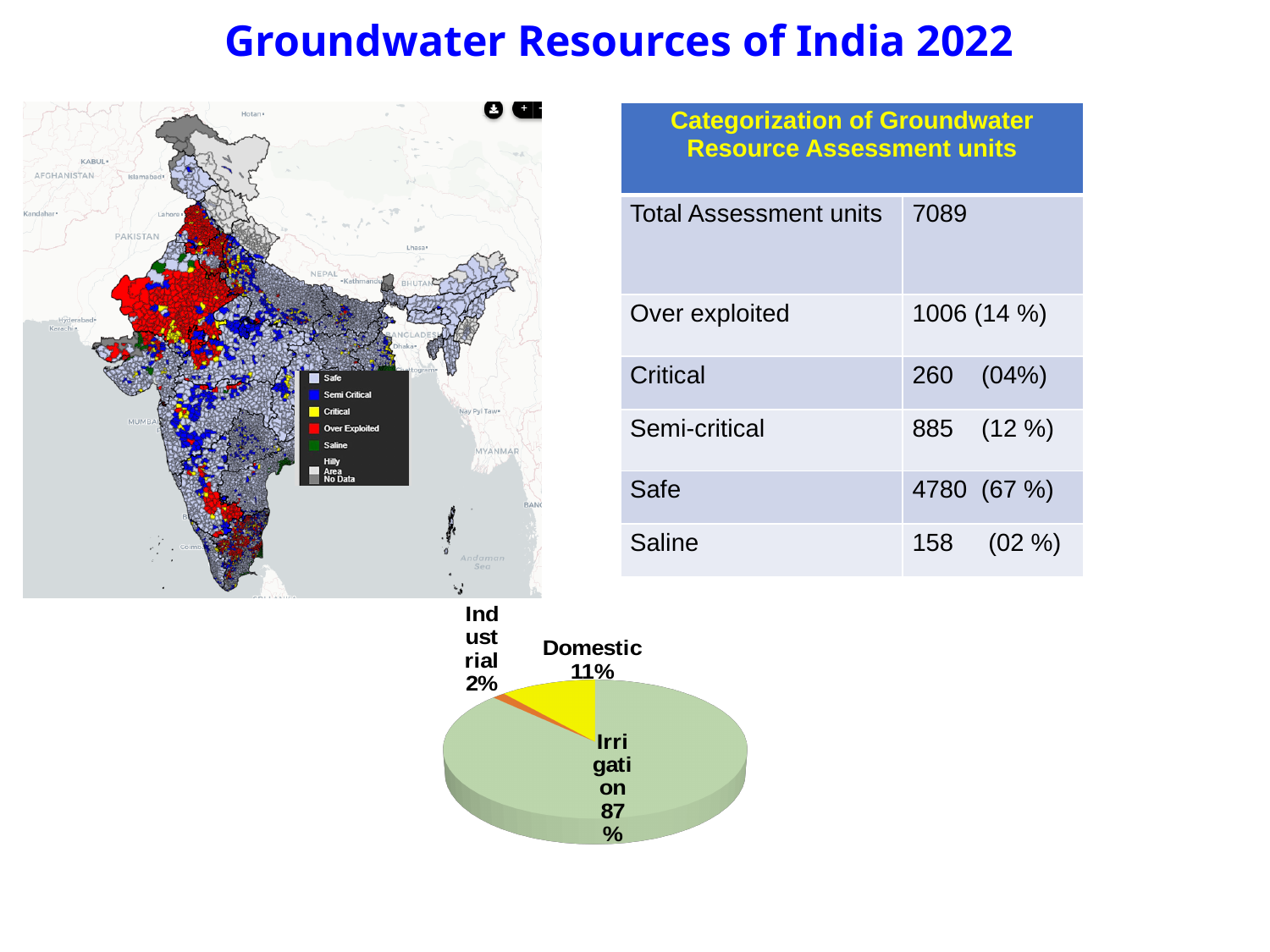
In the pie chart, what is the difference between the Irrigation share and the Domestic share? 76% In the pie chart, which is larger, the Irrigation slice or the Domestic slice? Irrigation In the pie chart, what share does Irrigation have? 87% In the pie chart, which is larger, the Domestic slice or the Industrial slice? Domestic What colour is the Irrigation slice in the pie chart? green How many slices does the pie chart have? 3 Which slice of the pie chart is the largest? Irrigation In the pie chart, what is the difference between the Domestic share and the Industrial share? 9% In the pie chart, what share does Domestic have? 11% In the pie chart, what share does Industrial have? 2% What kind of chart is shown at the bottom of the slide? pie chart Which slice of the pie chart is the smallest? Industrial